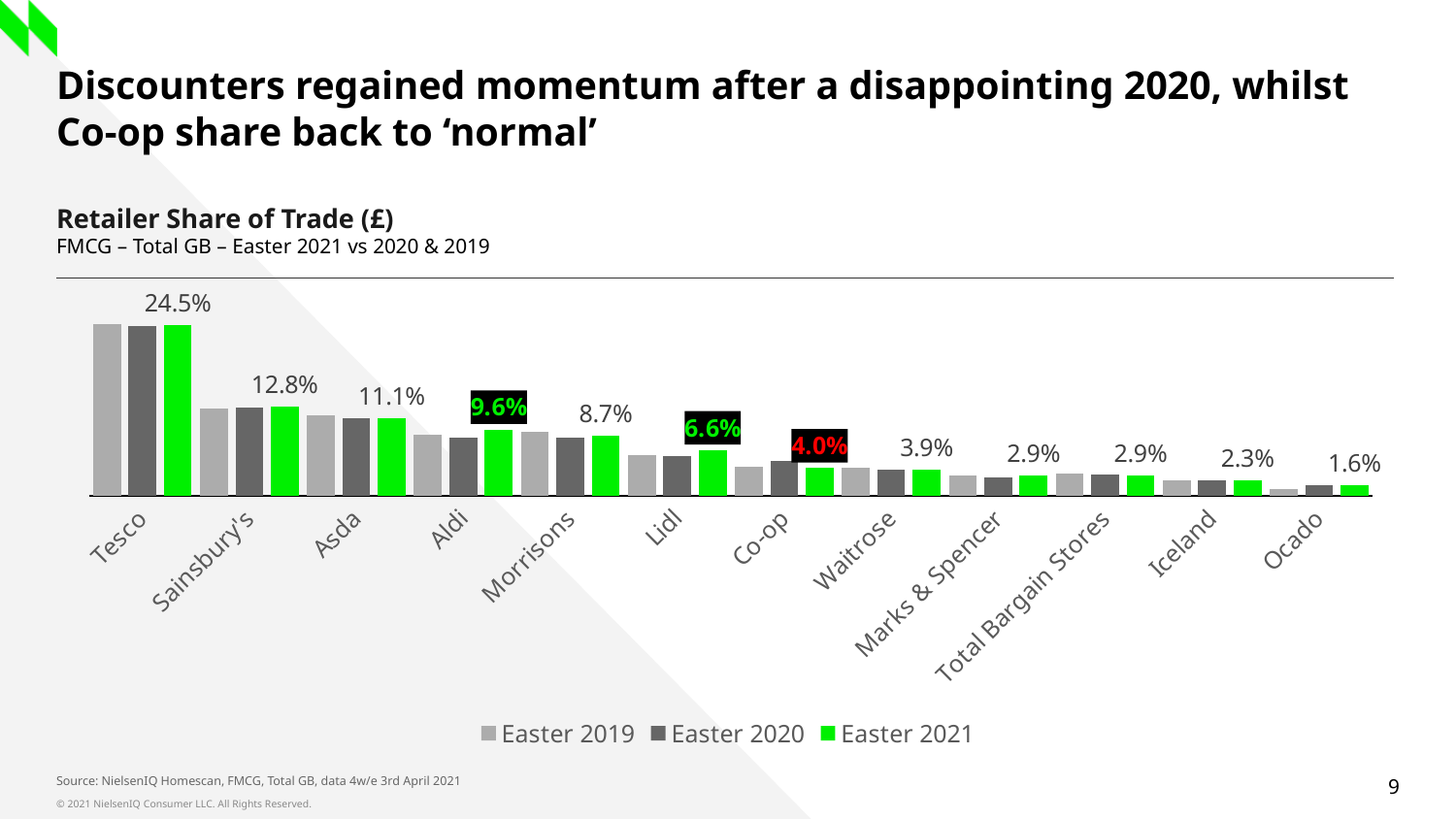
Which retailer has the highest Easter 2021 share of trade? Tesco What is the difference between the Easter 2021 shares of Tesco and Sainsbury's? 11.7 percentage points Which retailer has the lowest Easter 2021 share of trade? Ocado How many retailers are shown on the x axis? 12 What is the Easter 2021 share of trade for Co-op? 4.0% Do the Easter 2021 share values rise or fall moving from left to right along the x axis? Fall Which has the larger Easter 2021 share of trade, Lidl or Morrisons? Morrisons How many series does the legend list? 3 What type of chart is shown on the slide? Bar chart What is the Easter 2021 share of trade for Tesco? 24.5% What is the Easter 2021 share of trade for Ocado? 1.6% What is the Easter 2021 share of trade for Aldi? 9.6%